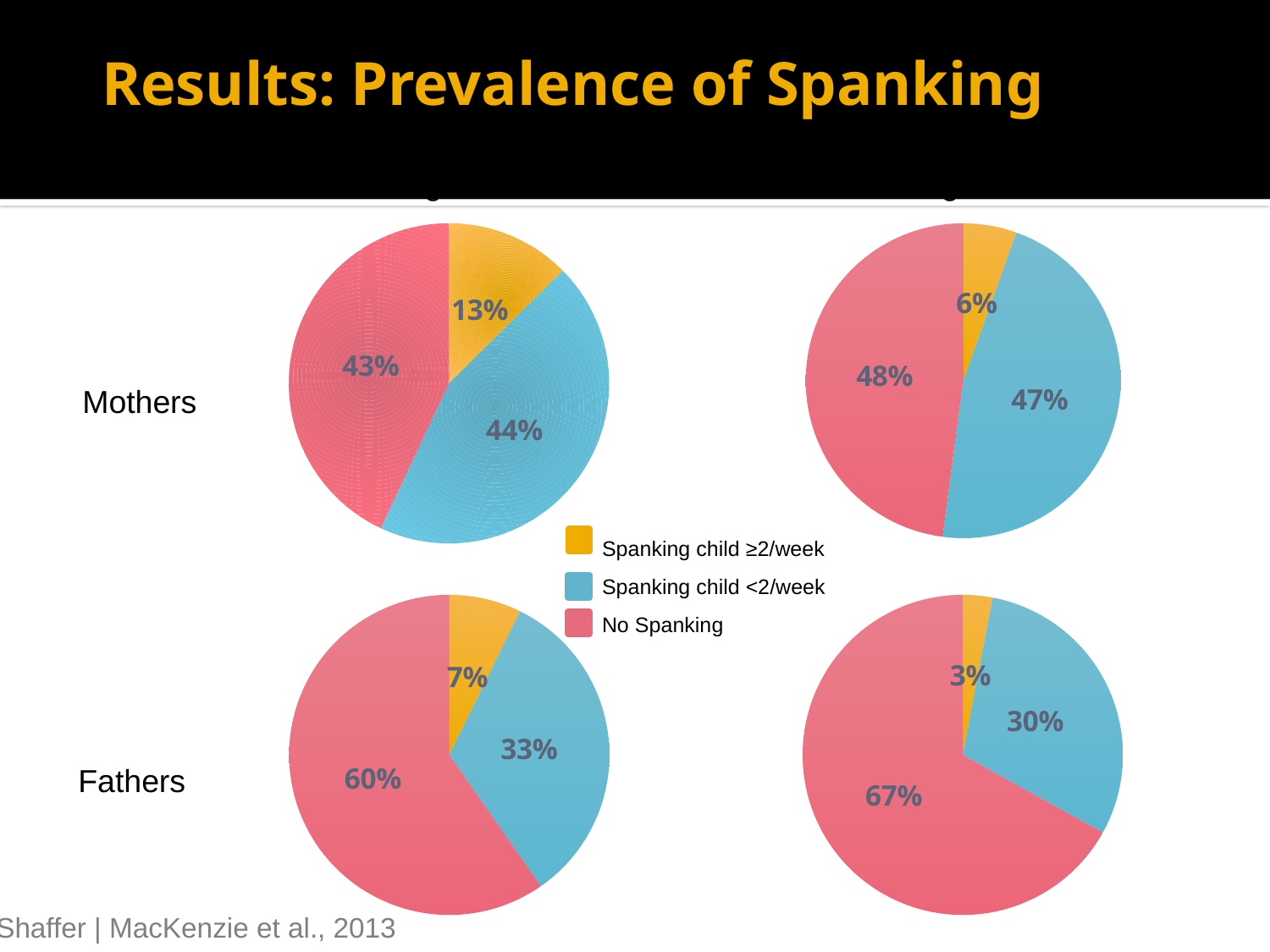
In the top-right pie chart (Mothers, right), what share is labelled for Spanking child <2/week? 47% Which is larger: the Spanking child ≥2/week share in the top-left pie chart (Mothers, left) or in the bottom-left pie chart (Fathers, left)? Top-left (Mothers, left) What type of chart is used for the Fathers data on this slide? Pie chart How many entries does the legend list? 3 In the top-left pie chart (Mothers, left), what share is labelled for No Spanking? 43% In the top-left pie chart (Mothers, left), which category has the smallest slice? Spanking child ≥2/week In the bottom-right pie chart (Fathers, right), which category has the largest slice? No Spanking In the bottom-left pie chart (Fathers, left), what share is labelled for No Spanking? 60% In the top-left pie chart (Mothers, left), what share is labelled for Spanking child ≥2/week? 13% In the bottom-left pie chart (Fathers, left), what is the difference between the No Spanking share and the Spanking child <2/week share? 27% How many slices does the top-right pie chart (Mothers, right) have? 3 In the bottom-right pie chart (Fathers, right), what share is labelled for Spanking child ≥2/week? 3%